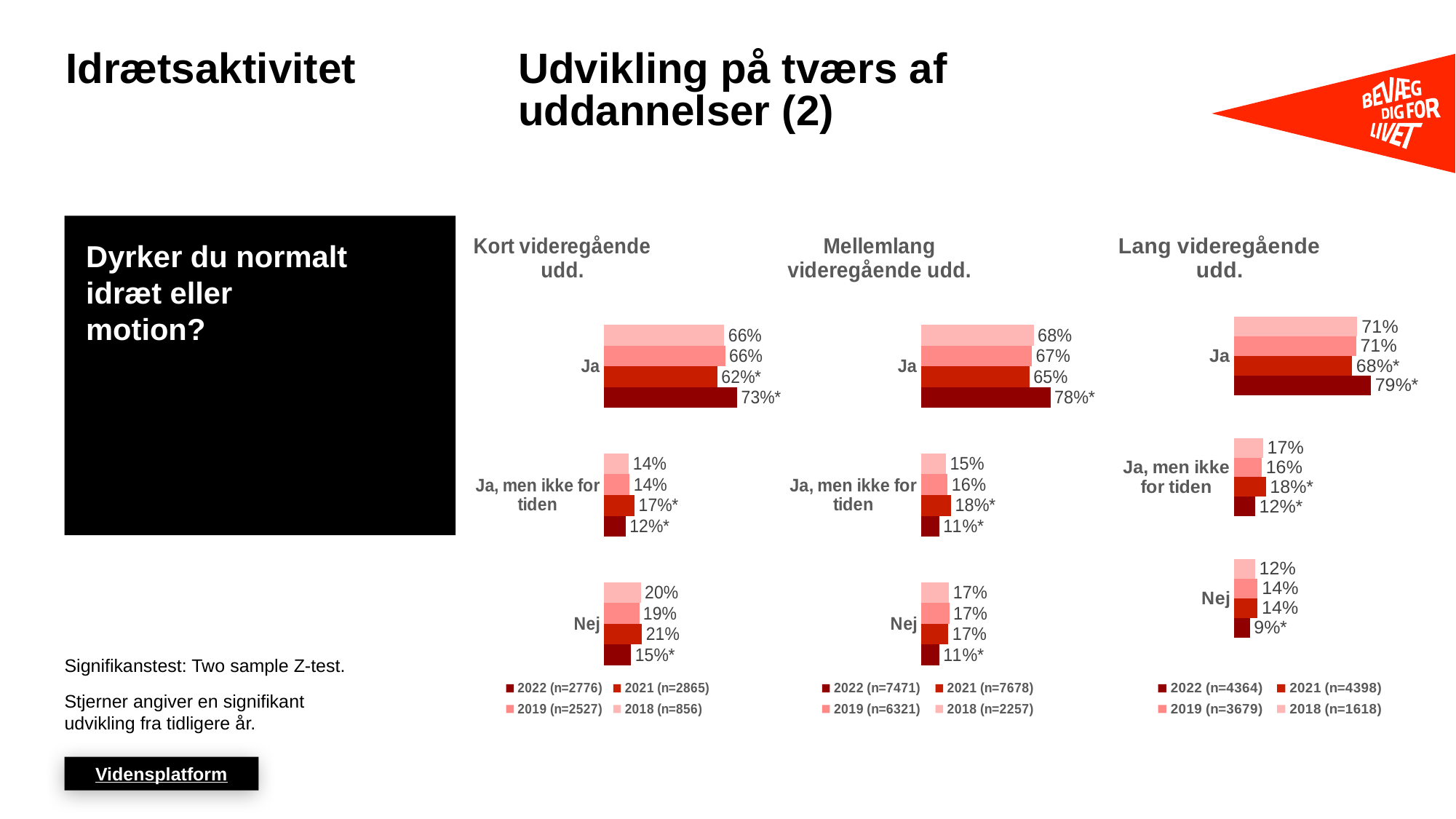
How many series does the legend list in the 'Mellemlang videregående udd.' chart? 4 In the 'Lang videregående udd.' chart, what is the 2021 value for 'Ja, men ikke for tiden'? 18%* In the 'Mellemlang videregående udd.' chart, which year has the highest value for 'Ja'? 2022 In the 'Lang videregående udd.' chart, what is the 2022 value for 'Nej'? 9%* What kind of chart is the 'Kort videregående udd.' chart? Bar chart In the 'Kort videregående udd.' chart, what is the difference between the 2022 and 2021 values for 'Ja'? 11 percentage points In the 'Mellemlang videregående udd.' chart, what is the 2018 value for 'Ja'? 68% How many response categories are shown in the 'Lang videregående udd.' chart? 3 In the 'Kort videregående udd.' chart, what is the 2022 value for 'Ja'? 73%* What sample size (n) does the legend give for 2022 in the 'Mellemlang videregående udd.' chart? n=7471 In the 'Kort videregående udd.' chart, which year has the lowest value for 'Nej'? 2022 In the 'Lang videregående udd.' chart, which is larger for 'Ja': the 2022 value or the 2018 value? 2022